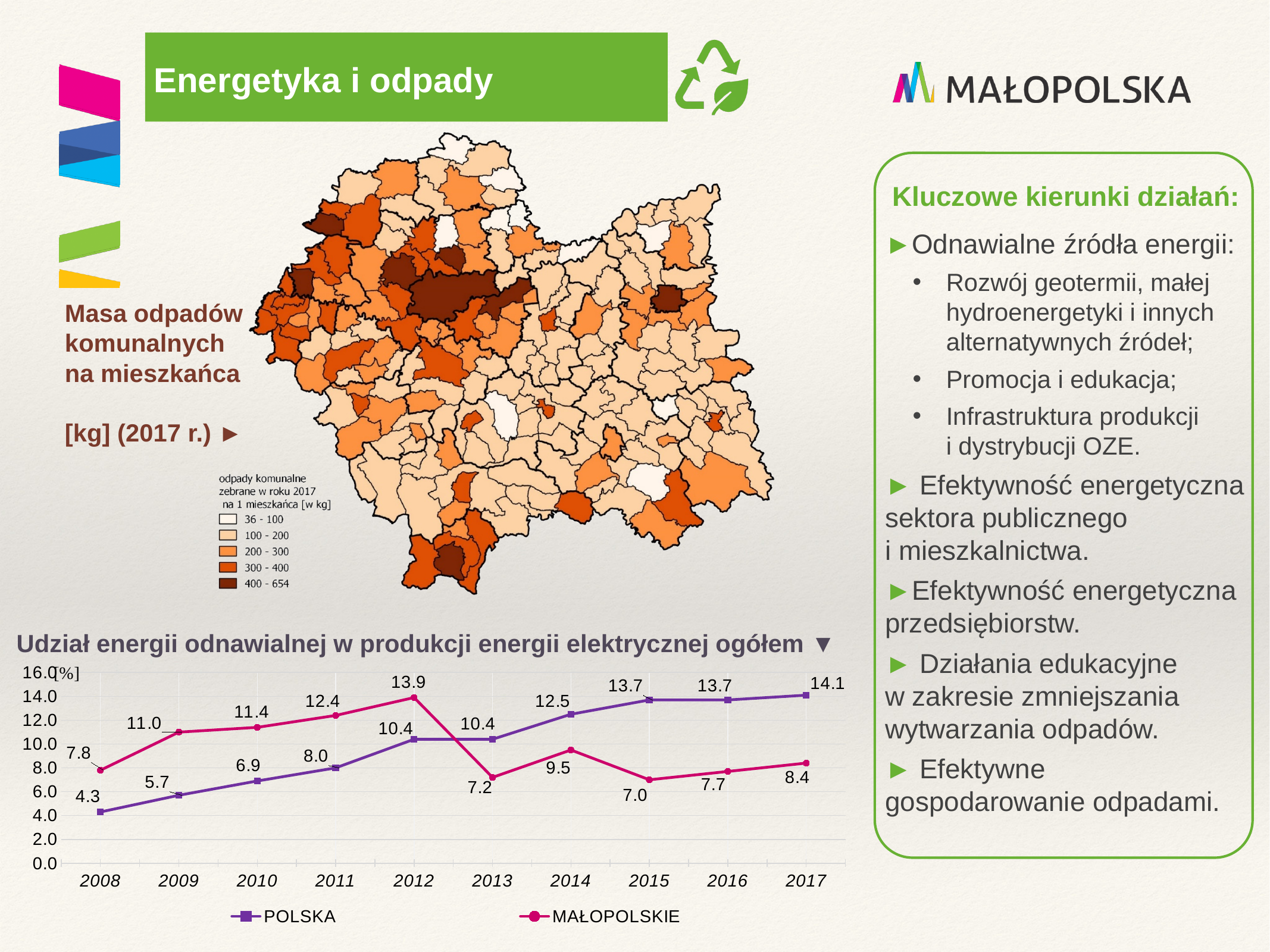
What kind of chart is 'Udział energii odnawialnej w produkcji energii elektrycznej ogółem'? Line chart In the line chart, in which year does the MAŁOPOLSKIE series have its lowest value? 2015 In the line chart, which series has the higher value in 2009, POLSKA or MAŁOPOLSKIE? MAŁOPOLSKIE In the line chart, what is the difference between the POLSKA and MAŁOPOLSKIE values in 2017? 5.7 In the line chart, what is the value for POLSKA in 2008? 4.3 In the line chart, what is the value for MAŁOPOLSKIE in 2012? 13.9 How many years are shown on the x axis of the line chart? 10 In the line chart, does the POLSKA series generally rise or fall from 2008 to 2017? Rise In the line chart, in which year does the MAŁOPOLSKIE series reach its highest value? 2012 How many series does the legend of the line chart list? 2 In the line chart 'Udział energii odnawialnej w produkcji energii elektrycznej ogółem', what is the value for POLSKA in 2017? 14.1 In the line chart, which series has the higher value in 2015, POLSKA or MAŁOPOLSKIE? POLSKA